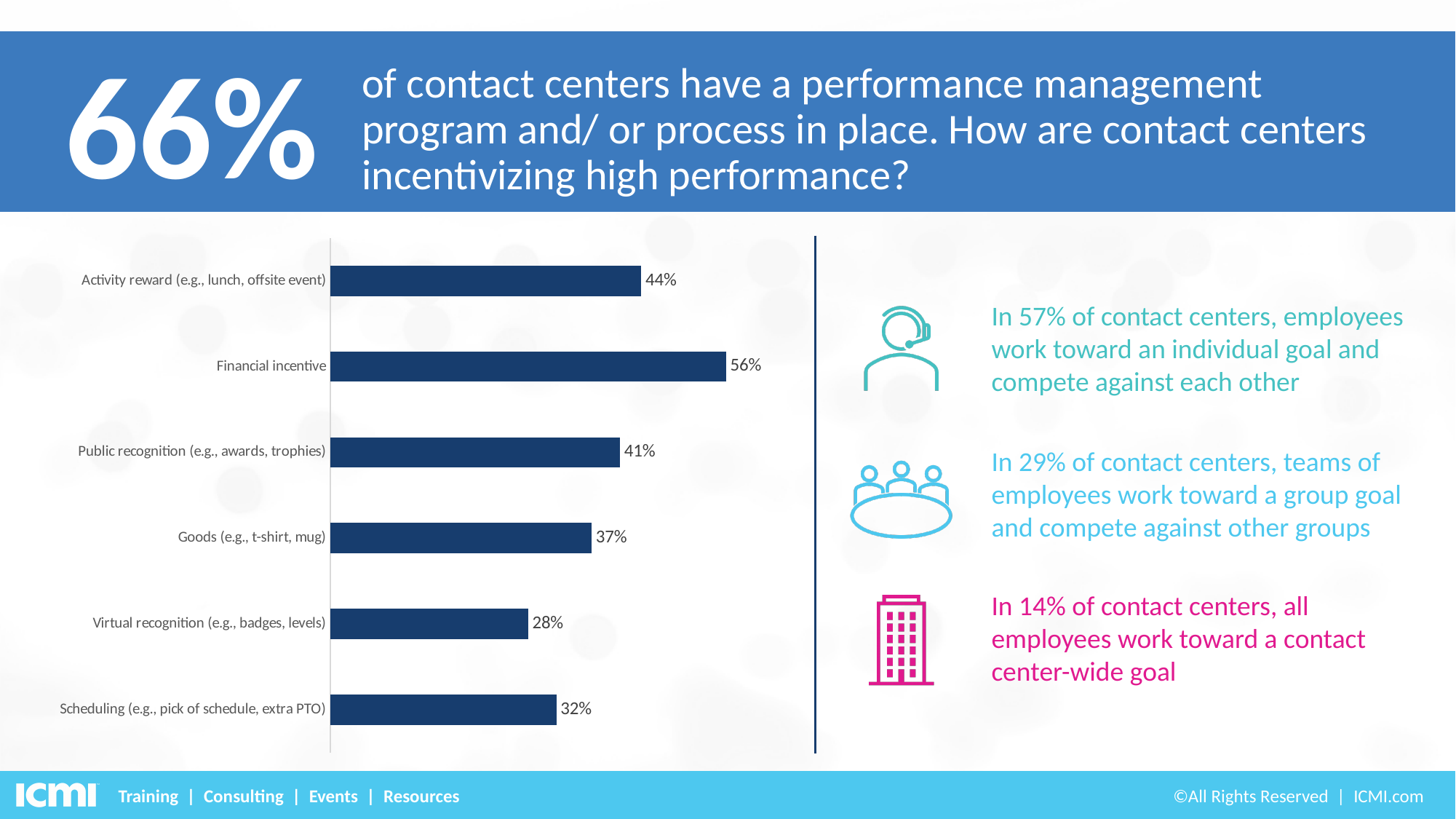
What is the difference between the values for Public recognition (e.g., awards, trophies) and Virtual recognition (e.g., badges, levels)? 13% What is the value for Financial incentive? 56% Which is larger, the value for Scheduling (e.g., pick of schedule, extra PTO) or the value for Goods (e.g., t-shirt, mug)? Goods (e.g., t-shirt, mug) What is the value for Scheduling (e.g., pick of schedule, extra PTO)? 32% What is the difference between the values for Financial incentive and Activity reward (e.g., lunch, offsite event)? 12% What is the value for Goods (e.g., t-shirt, mug)? 37% Which category has the lowest value? Virtual recognition (e.g., badges, levels) Which category has the highest value? Financial incentive What is the value for Virtual recognition (e.g., badges, levels)? 28% How many categories are shown in the bar chart? 6 What kind of chart is shown on the slide? Bar chart Which is larger, the value for Activity reward (e.g., lunch, offsite event) or the value for Public recognition (e.g., awards, trophies)? Activity reward (e.g., lunch, offsite event)